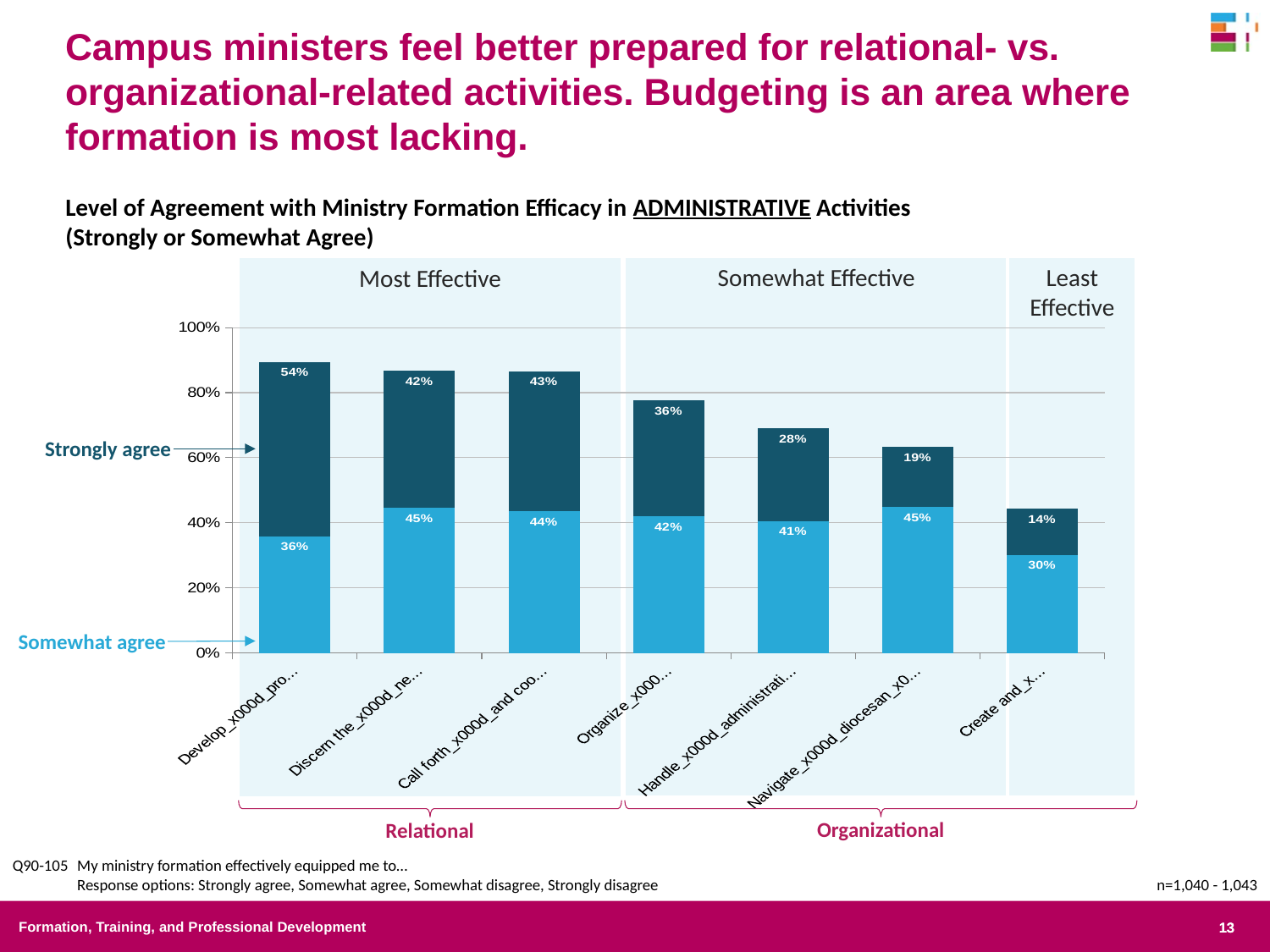
Do the total bar heights rise or fall from left to right along the x axis? fall What is the 'Strongly agree' value for the single bar in the 'Least Effective' section? 14% How many series does the chart show (as labelled on the left of the chart)? 2 What kind of chart is shown on the slide? stacked bar chart How many bars are plotted in the chart? 7 What is the 'Somewhat agree' value for the leftmost bar in the chart? 36% What is the total of the rightmost stacked bar (Strongly agree plus Somewhat agree)? 44% What is the 'Strongly agree' value for the leftmost bar in the chart? 54% What is the total of the leftmost stacked bar (Strongly agree plus Somewhat agree)? 90% Which bar has the highest 'Strongly agree' value? the leftmost bar (54%) What is the difference between the 'Strongly agree' values of the leftmost bar and the rightmost bar? 40% What is the 'Somewhat agree' value for the single bar in the 'Least Effective' section? 30%